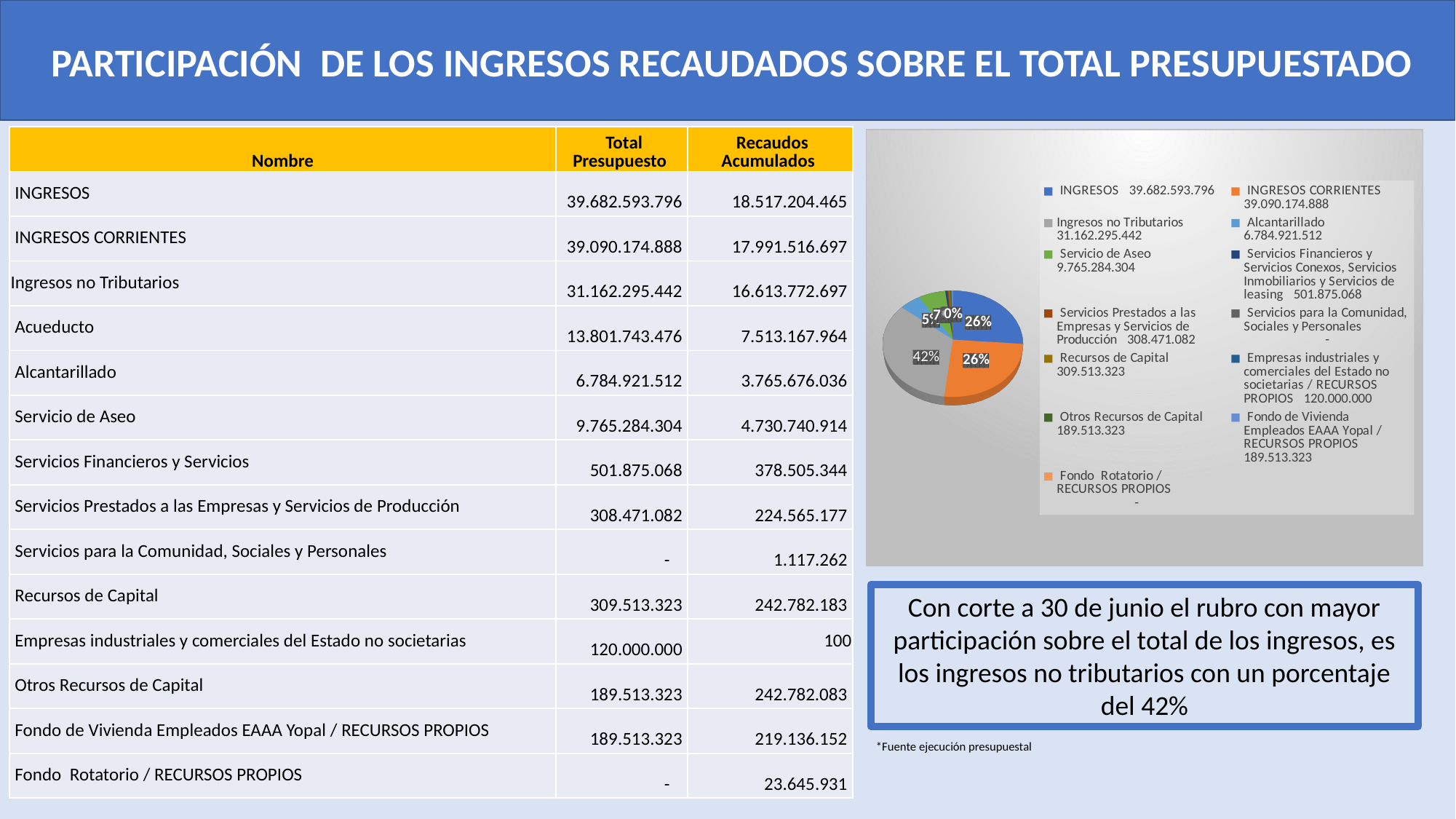
In the pie chart legend, what value is listed for Empresas industriales y comerciales del Estado no societarias / RECURSOS PROPIOS? 120.000.000 In the pie chart legend, what value is listed for INGRESOS? 39.682.593.796 In the pie chart legend, what value is listed for Servicio de Aseo? 9.765.284.304 According to the pie chart legend, which is larger: the value for INGRESOS or the value for Alcantarillado? INGRESOS What colour is the slice representing the 42% share in the pie chart? gray In the pie chart, what is the largest percentage shown on a slice? 42% In the pie chart legend, what value is listed for Alcantarillado? 6.784.921.512 How many entries does the pie chart legend list? 13 What kind of chart is shown on the right side of the slide? pie chart Using the legend values, what is the difference between Recursos de Capital (309.513.323) and Otros Recursos de Capital (189.513.323)? 120.000.000 In the pie chart legend, what value is listed for Recursos de Capital? 309.513.323 According to the slide, which category has the largest share (42%) of the pie chart? Ingresos no Tributarios